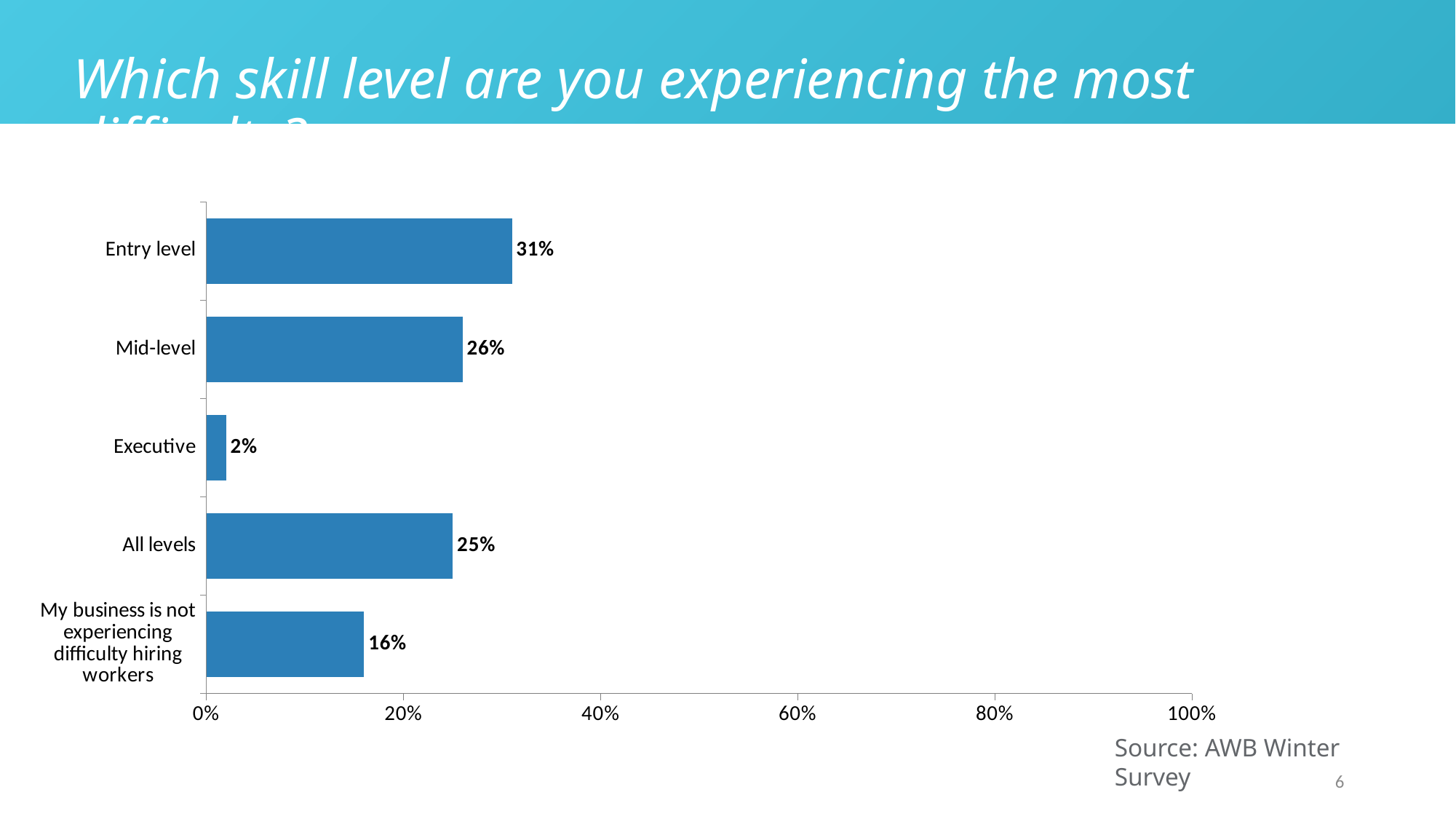
How many categories are shown in the chart? 5 What percentage is shown for Entry level? 31% What is the difference between the All levels and Executive percentages? 23% Which skill level category has the highest percentage? Entry level Which category has the lowest percentage? Executive What percentage is shown for Mid-level? 26% What type of chart is shown on the slide? Bar chart What percentage is shown for All levels? 25% What percentage is shown for 'My business is not experiencing difficulty hiring workers'? 16% What is the difference between the Entry level and Mid-level percentages? 5% Which is larger, the value for Entry level or the value for All levels? Entry level What percentage is shown for Executive? 2%